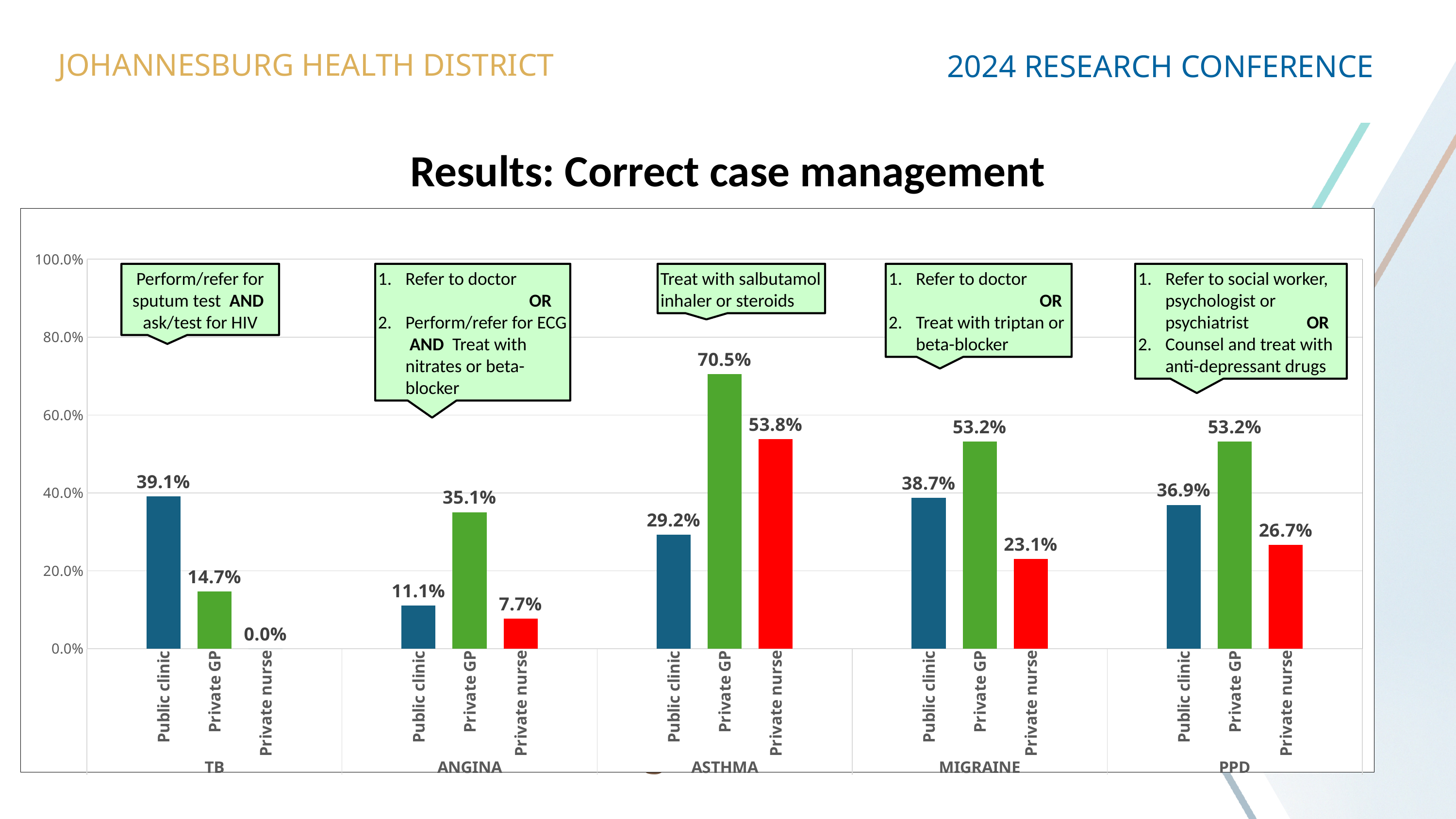
What is the difference between Private GP and Public clinic in the ANGINA group? 24.0% How many condition groups are shown on the x axis? 5 What is the value for Private GP in the ASTHMA group? 70.5% What is the title of the slide's chart section? Results: Correct case management What is the value for Public clinic in the TB group? 39.1% What kind of chart is shown on the slide? Bar chart Which bar has the highest value on the chart? Private GP in ASTHMA What is the value for Private nurse in the MIGRAINE group? 23.1% Which is larger in the PPD group: Public clinic or Private nurse? Public clinic Which bar has the lowest value on the chart? Private nurse in TB What is the value for Private nurse in the TB group? 0.0% Is the value for Private GP in the ASTHMA group greater or less than 60.0%? greater